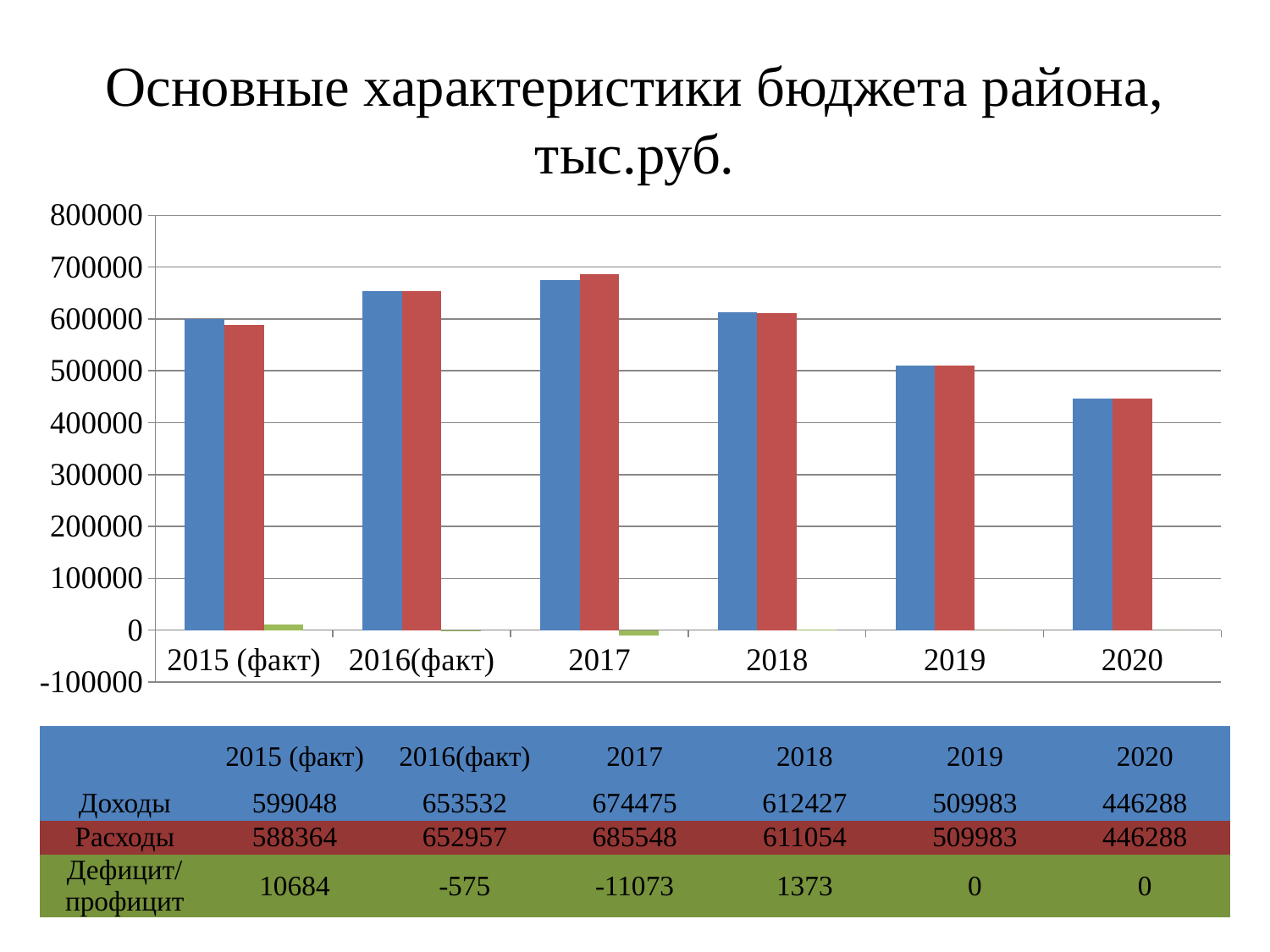
Is the value of Доходы for 2019 greater or less than 600000? less Which is larger in 2017, Доходы or Расходы? Расходы What type of chart is shown on the slide? Bar chart What is the difference between Доходы and Расходы in 2015 (факт)? 10684 In which year is Расходы the lowest? 2020 How many series does the data table below the chart list? 3 Do the Доходы values rise or fall from 2017 to 2020? fall What is the value of Расходы for 2015 (факт)? 588364 How many year categories are shown on the x axis of the chart? 6 What is the value of Дефицит/профицит for 2018? 1373 In which year is Доходы the highest? 2017 What is the value of Доходы for 2017? 674475